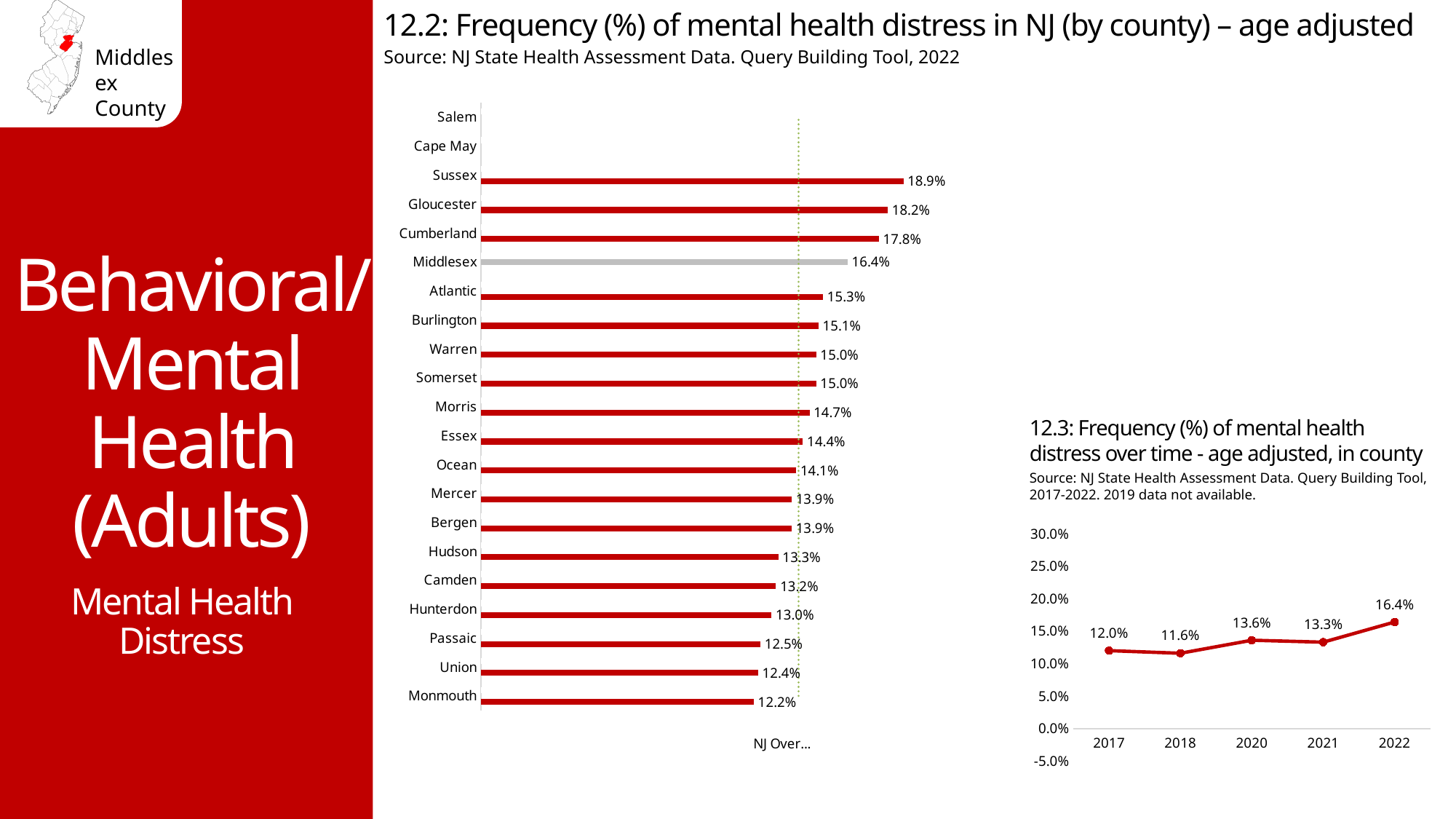
In chart 12.3, what is the value for 2018? 11.6% In chart 12.2, what is the value for Middlesex? 16.4% In chart 12.3, which year has the highest value? 2022 In chart 12.2, which county with a plotted bar has the lowest value? Monmouth In chart 12.2, what is the value for Cumberland? 17.8% In chart 12.2, which has a larger value, Gloucester or Atlantic? Gloucester In chart 12.3, how many years are plotted? 5 In chart 12.2, which county has the highest value? Sussex In chart 12.2, what is the difference between the values for Sussex and Monmouth? 6.7% In chart 12.2, what is the value for Hunterdon? 13.0% In chart 12.3, what is the difference between the values for 2022 and 2021? 3.1% What kind of chart is chart 12.2? Bar chart